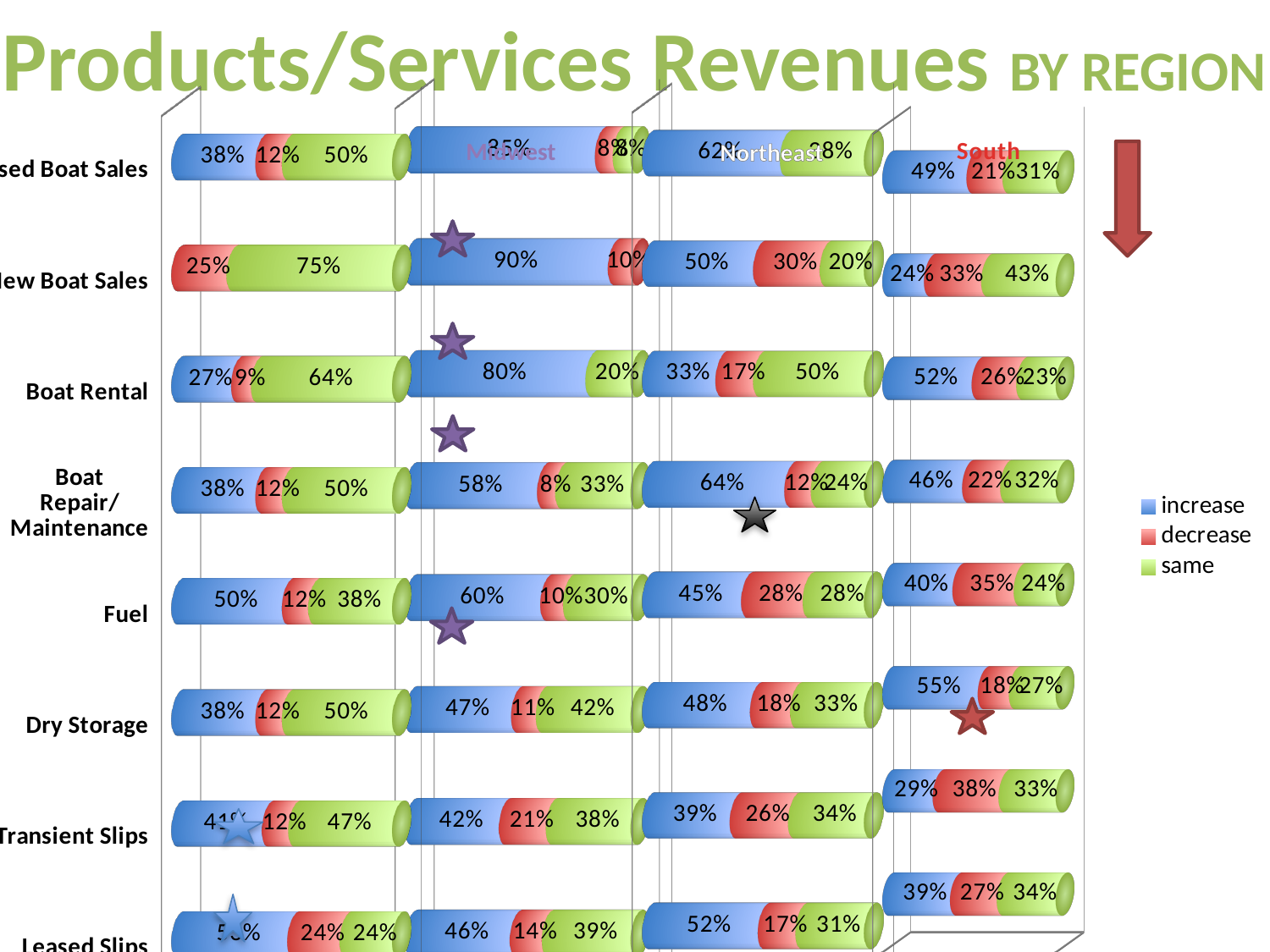
What is the 'increase' value for Boat Repair/Maintenance in the Northeast? 64% What is the 'same' value for Boat Rental in the Northeast? 50% What is the difference between the 'increase' values for Boat Rental in the Midwest (80%) and in the Northeast (33%)? 47% What is the 'increase' value for Dry Storage in the South? 55% What is the 'decrease' value for Transient Slips in the South? 38% Which legend entry is shown in red? decrease What kind of chart is shown on the slide? Stacked bar chart Which is larger: the 'decrease' value for Fuel in the South or the 'decrease' value for Fuel in the Midwest? South How many series does the legend list? 3 What is the 'same' value for New Boat Sales in the South? 43% Among the Midwest bars, which category has the highest 'increase' value? New Boat Sales What is the 'increase' value for New Boat Sales in the Midwest? 90%